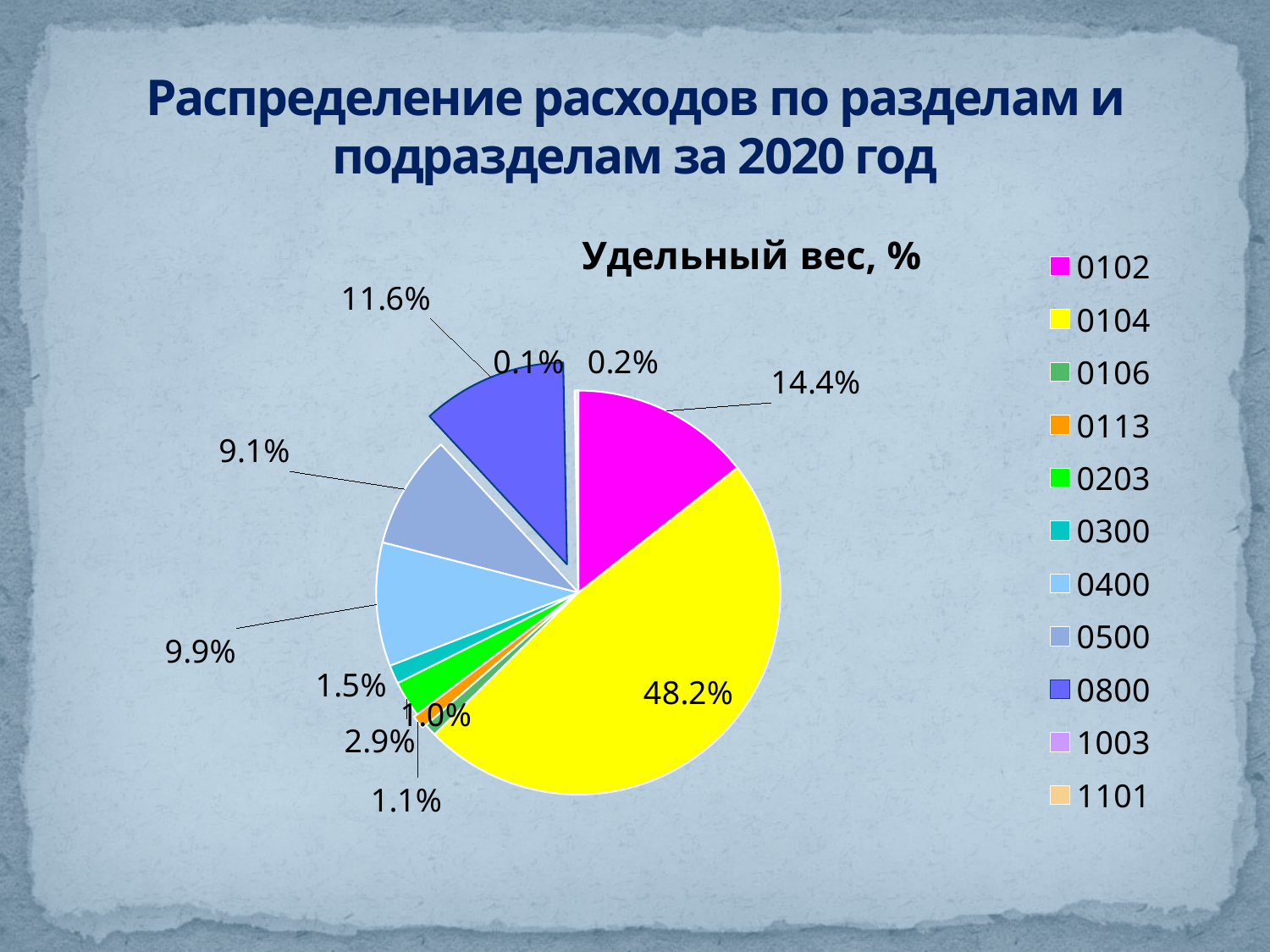
What is the share for category 0800? 11.6% Which category has the largest share of the pie? 0104 What is the difference between the shares of 0104 and 0102? 33.8% What is the title of the chart? Удельный вес, % What kind of chart is shown on the slide? pie chart What is the share for category 0400? 9.9% Which category has the smallest share of the pie? 1003 How many categories does the legend list? 11 What is the share for category 0500? 9.1% Which category has the larger share, 0400 or 0500? 0400 What is the share for category 0102? 14.4% What is the share for category 0104? 48.2%